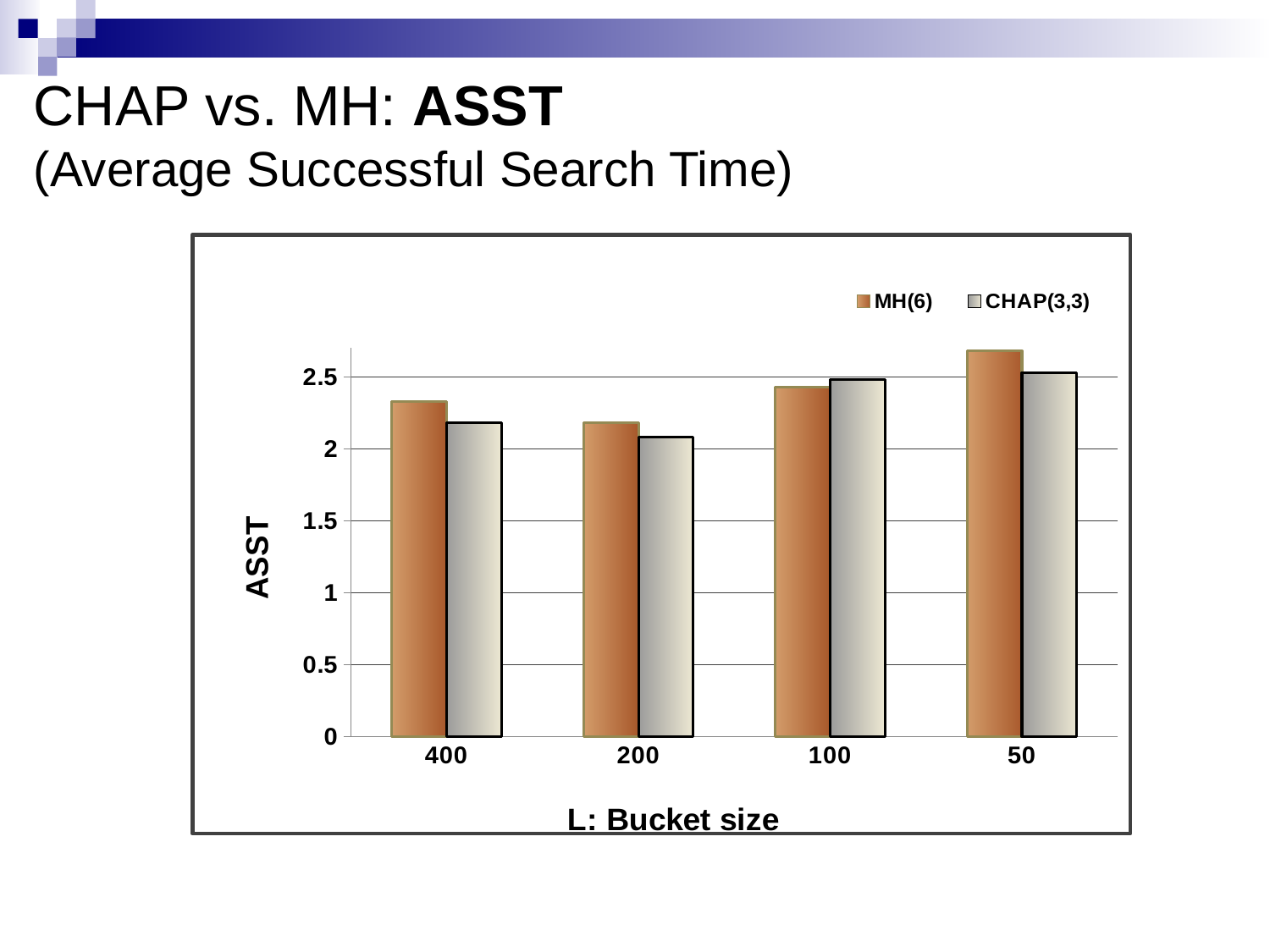
For which bucket size is the MH(6) value highest? 50 At bucket size 400, which series has the larger value, MH(6) or CHAP(3,3)? MH(6) At bucket size 50, which series has the larger value, MH(6) or CHAP(3,3)? MH(6) Is the MH(6) value for bucket size 50 greater or less than 2.5? greater Which series are listed in the legend? MH(6) and CHAP(3,3) What kind of chart is shown on the slide? bar chart For which bucket size is the MH(6) value lowest? 200 Is the MH(6) value for bucket size 200 greater or less than 2? greater Is the MH(6) value for bucket size 400 greater or less than 2.5? less What is the label of the x axis? L: Bucket size How many bucket size categories are shown on the x axis? 4 How many series does the legend list? 2